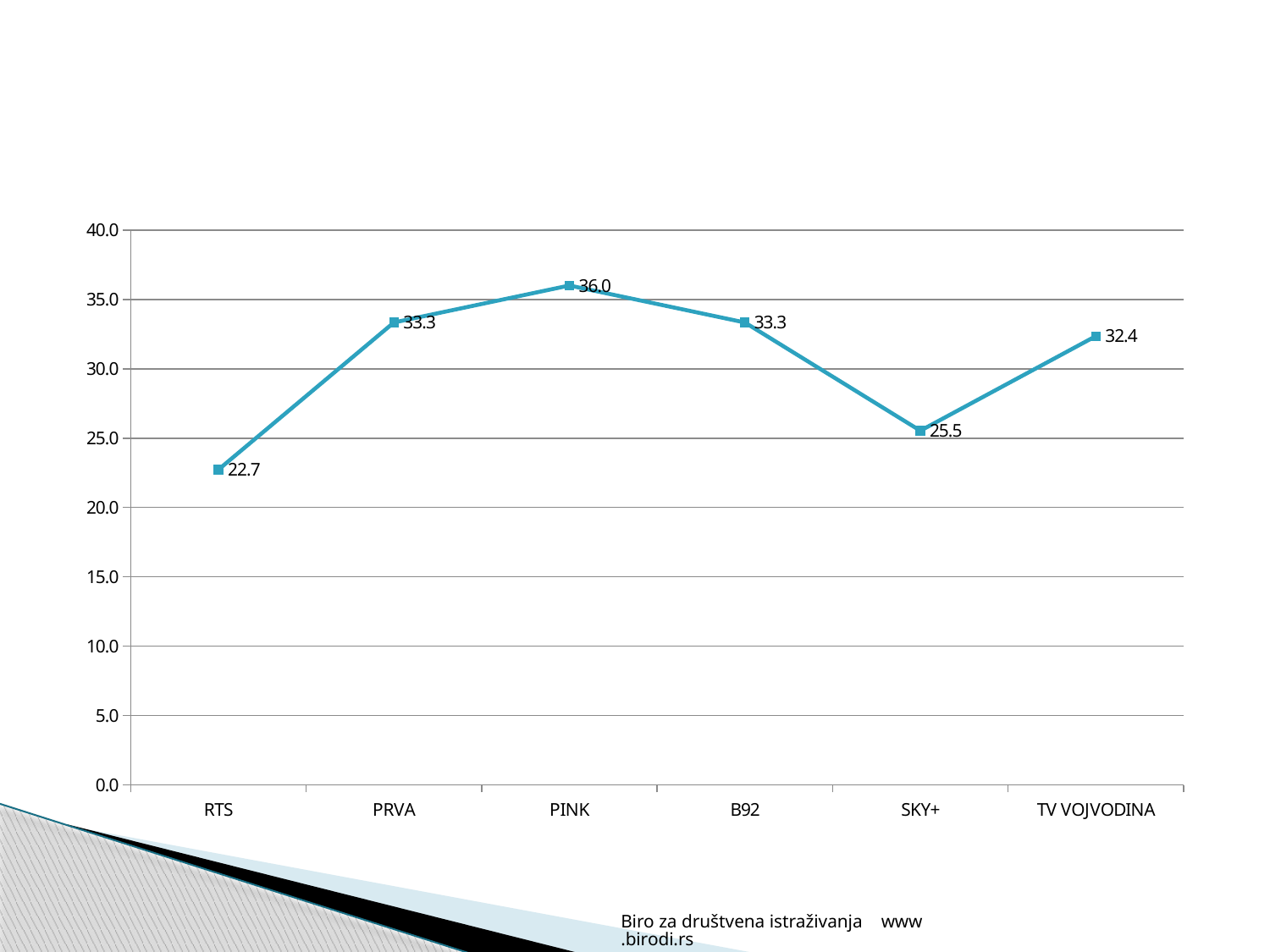
Which is larger, the value for PRVA or the value for SKY+? PRVA Which category has the lowest value? RTS What kind of chart is shown on the slide? line chart What is the value for RTS? 22.7 How many categories are plotted on the x axis? 6 What is the value for TV VOJVODINA? 32.4 What is the difference between the values for TV VOJVODINA and SKY+? 6.9 What is the difference between the values for PINK and RTS? 13.3 Which category has the highest value? PINK What is the value for PINK? 36.0 What is the value for SKY+? 25.5 Does the value rise or fall from B92 to SKY+? fall